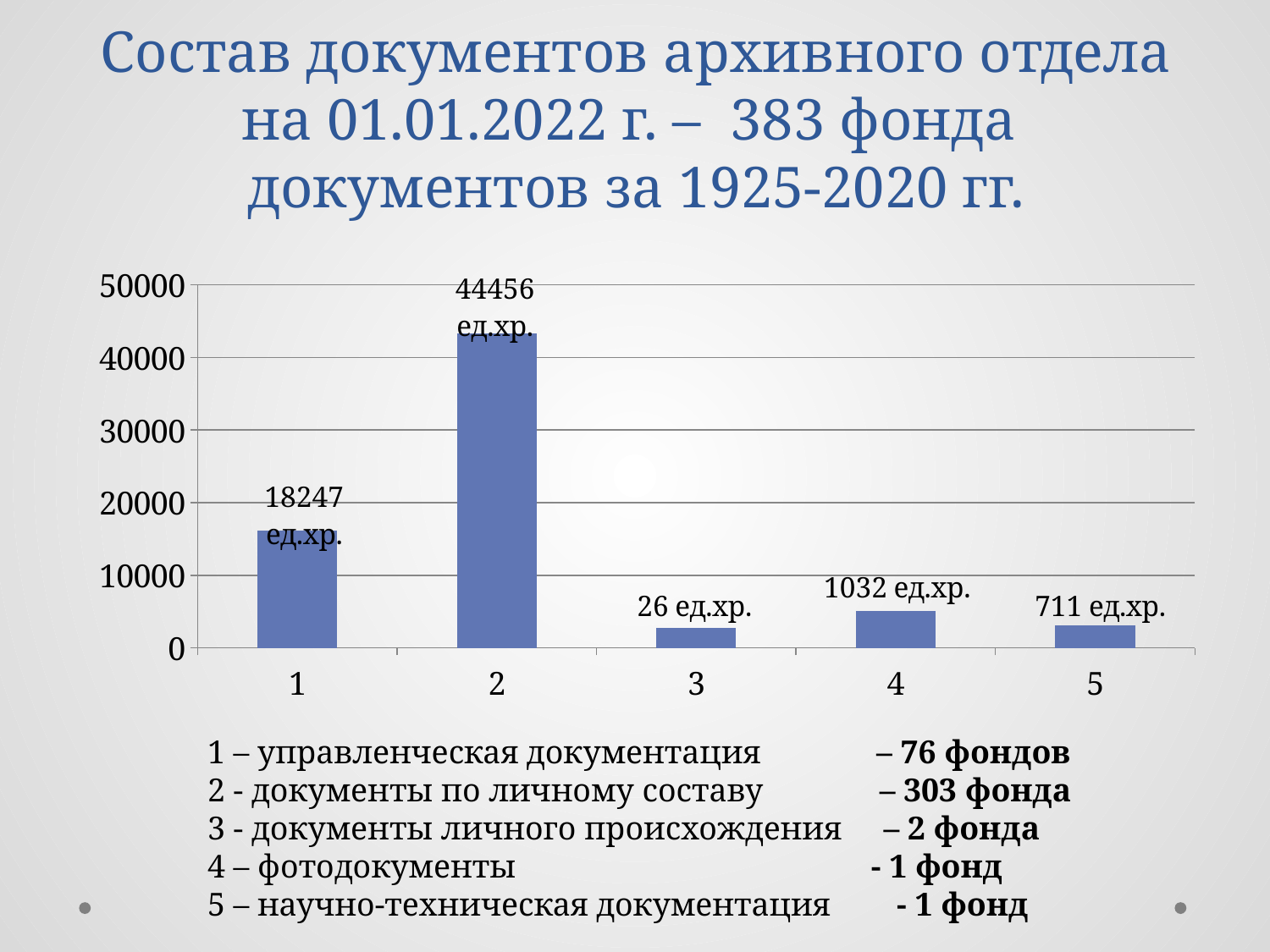
Which category has the lowest value? 3 How many categories are plotted on the x axis of the chart? 5 What is the value shown for category 4? 1032 ед.хр. What is the value shown for category 3? 26 ед.хр. What is the value shown for category 1? 18247 ед.хр. What is the value shown for category 2? 44456 ед.хр. What is the value shown for category 5? 711 ед.хр. What is the difference between the values for category 2 and category 1? 26209 ед.хр. Is the value for category 2 greater or less than 40000? greater Which has the larger value, category 4 or category 5? 4 Which category has the highest value? 2 What type of chart is shown on the slide? Bar chart